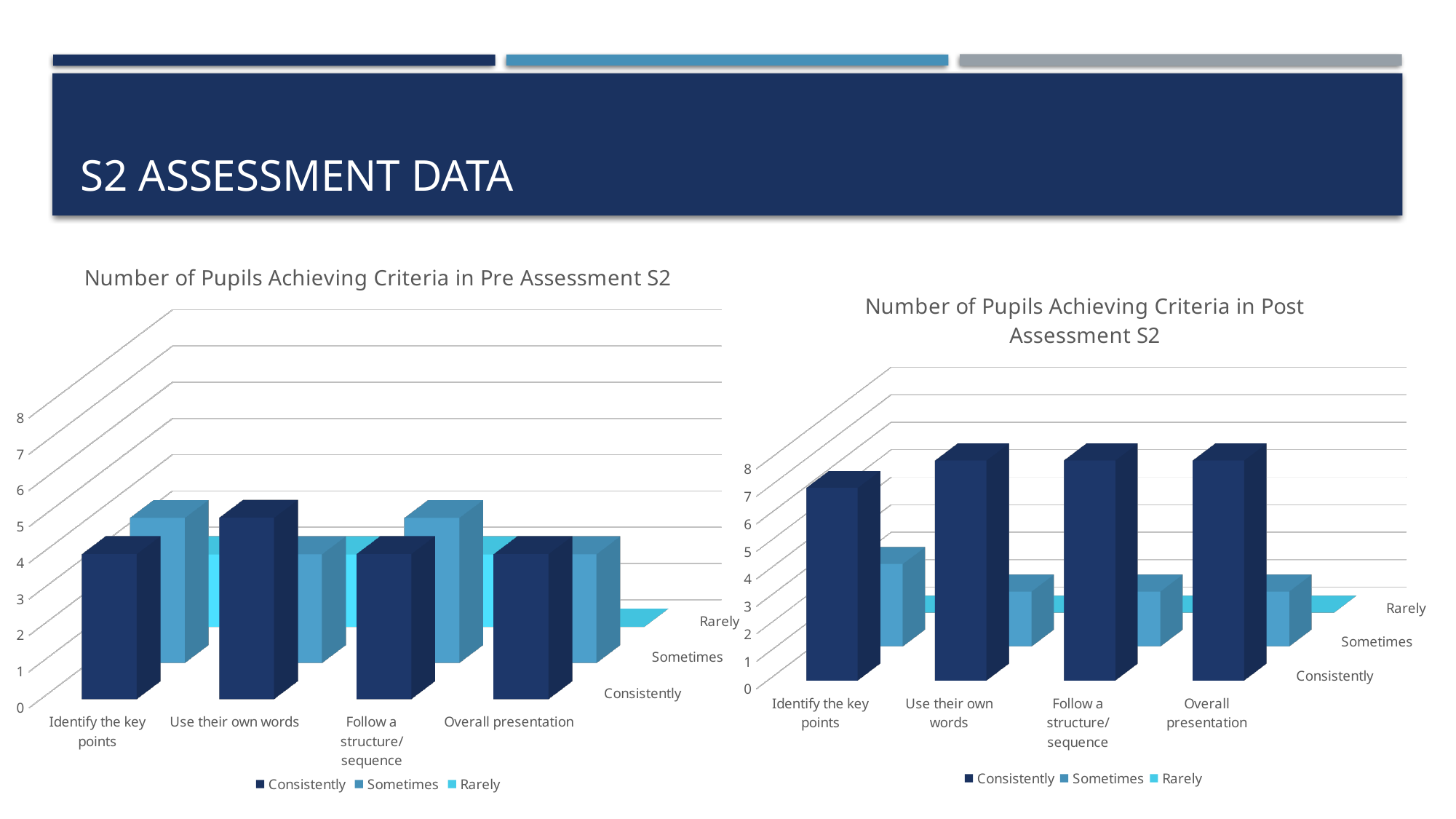
In the 'Number of Pupils Achieving Criteria in Post Assessment S2' chart, is the Consistently value for 'Use their own words' greater or less than 4? greater In the 'Number of Pupils Achieving Criteria in Post Assessment S2' chart, which series has the tallest bars across all categories? Consistently In the 'Number of Pupils Achieving Criteria in Pre Assessment S2' chart, which series has the lowest values across all categories? Rarely In the 'Number of Pupils Achieving Criteria in Pre Assessment S2' chart, is the Consistently value for 'Identify the key points' greater or less than 8? less How many categories are shown on the x axis of the 'Number of Pupils Achieving Criteria in Post Assessment S2' chart? 4 How many series does the legend of the 'Number of Pupils Achieving Criteria in Pre Assessment S2' chart list? 3 What is the title of the chart on the right of the slide? Number of Pupils Achieving Criteria in Post Assessment S2 In the 'Number of Pupils Achieving Criteria in Post Assessment S2' chart, which is larger for the Consistently series: 'Identify the key points' or 'Use their own words'? Use their own words In the 'Number of Pupils Achieving Criteria in Post Assessment S2' chart, is the Sometimes value for 'Identify the key points' greater or less than 6? less In the 'Number of Pupils Achieving Criteria in Pre Assessment S2' chart, which series is shown in the darkest blue? Consistently What kind of chart is the 'Number of Pupils Achieving Criteria in Pre Assessment S2' chart? Bar chart